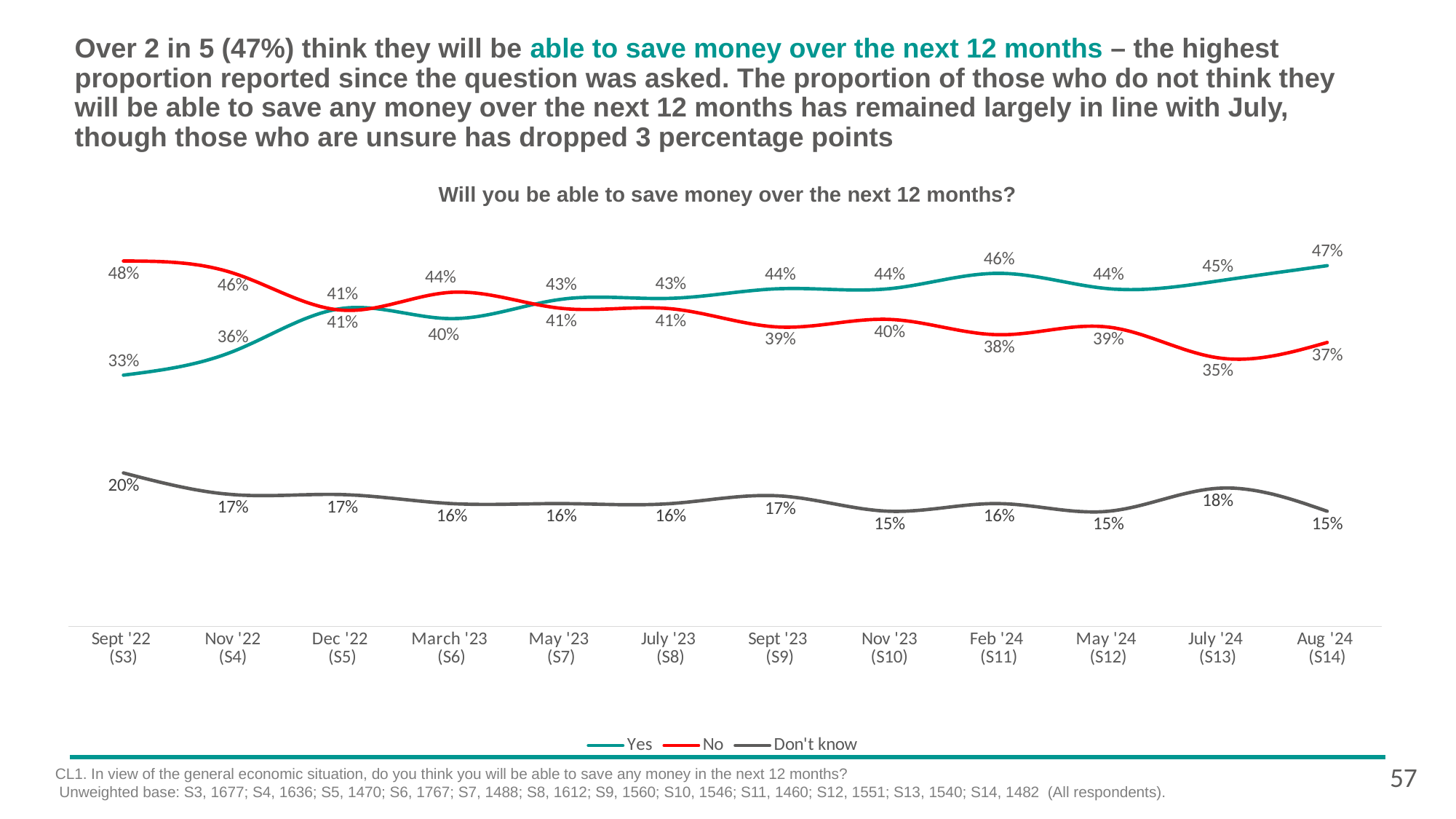
What is the value for Don't know in July '24 (S13)? 18% How many series does the legend list? 3 What is the title of the chart? Will you be able to save money over the next 12 months? What is the value for No in Sept '22 (S3)? 48% In which time point is the Yes series at its highest? Aug '24 (S14) Does the Yes series generally rise or fall from Sept '22 to Aug '24? Rise What is the difference between the Yes and No values in Aug '24 (S14)? 10 percentage points Which is larger in Sept '22 (S3), the Yes value or the No value? No What is the value for Yes in Aug '24 (S14)? 47% In which time point is the No series at its lowest? July '24 (S13) How many time points are shown on the x axis? 12 What type of chart is shown on the slide? Line chart